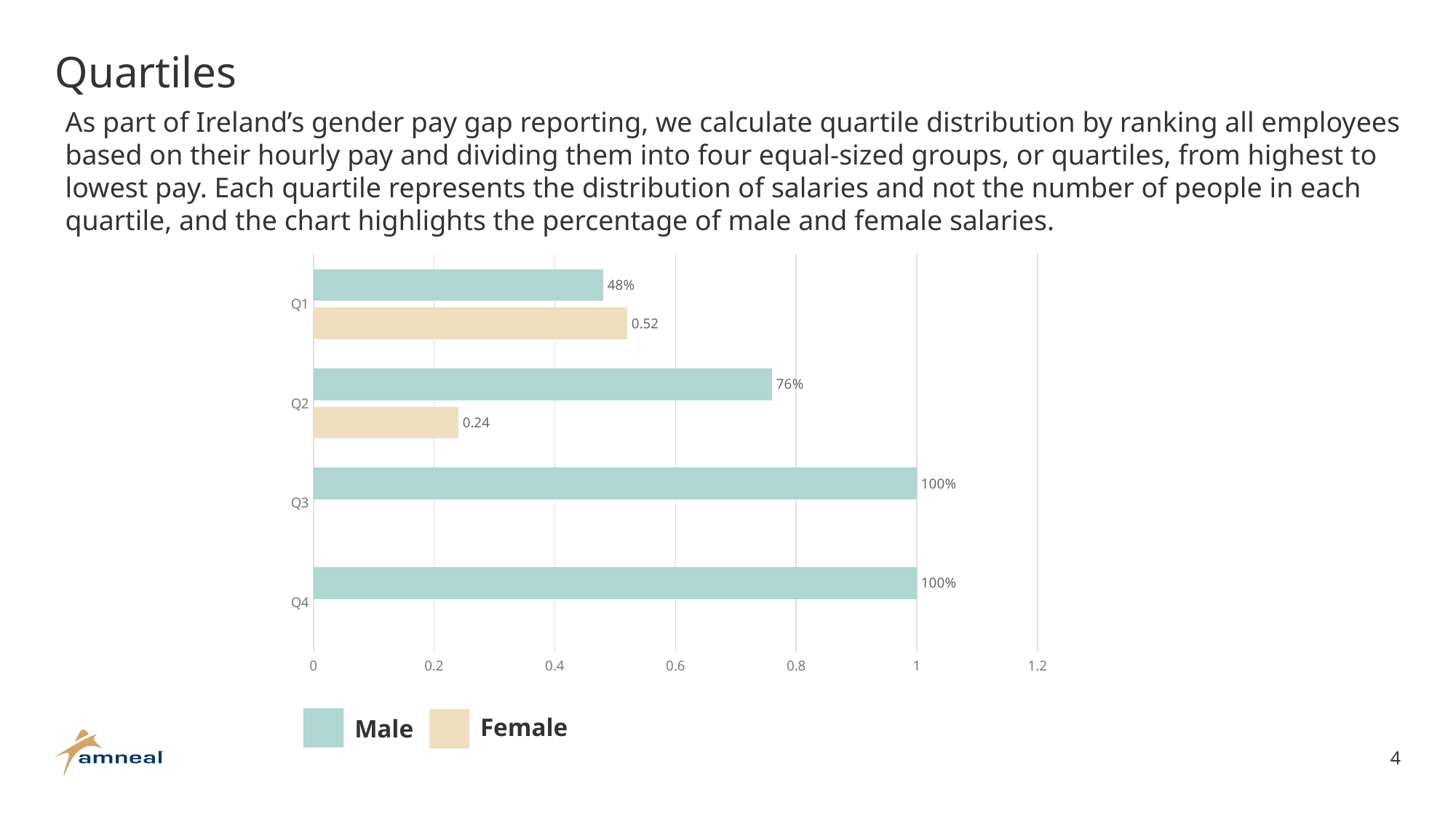
Which quartile has the highest Female value? Q1 What is the Female value for Q1? 0.52 What is the Female value for Q2? 0.24 Is the Female value for Q2 greater or less than 0.4? less Which is larger, the Male value for Q2 or the Male value for Q1? Male value for Q2 How many series does the legend list? 2 What kind of chart is shown on the slide? bar chart Which quartile has the lowest Male value? Q1 What is the difference between the Male values for Q2 and Q1? 28% What is the Male value for Q3? 100% What is the Male value for Q1? 48% How many quartile categories are shown on the chart? 4